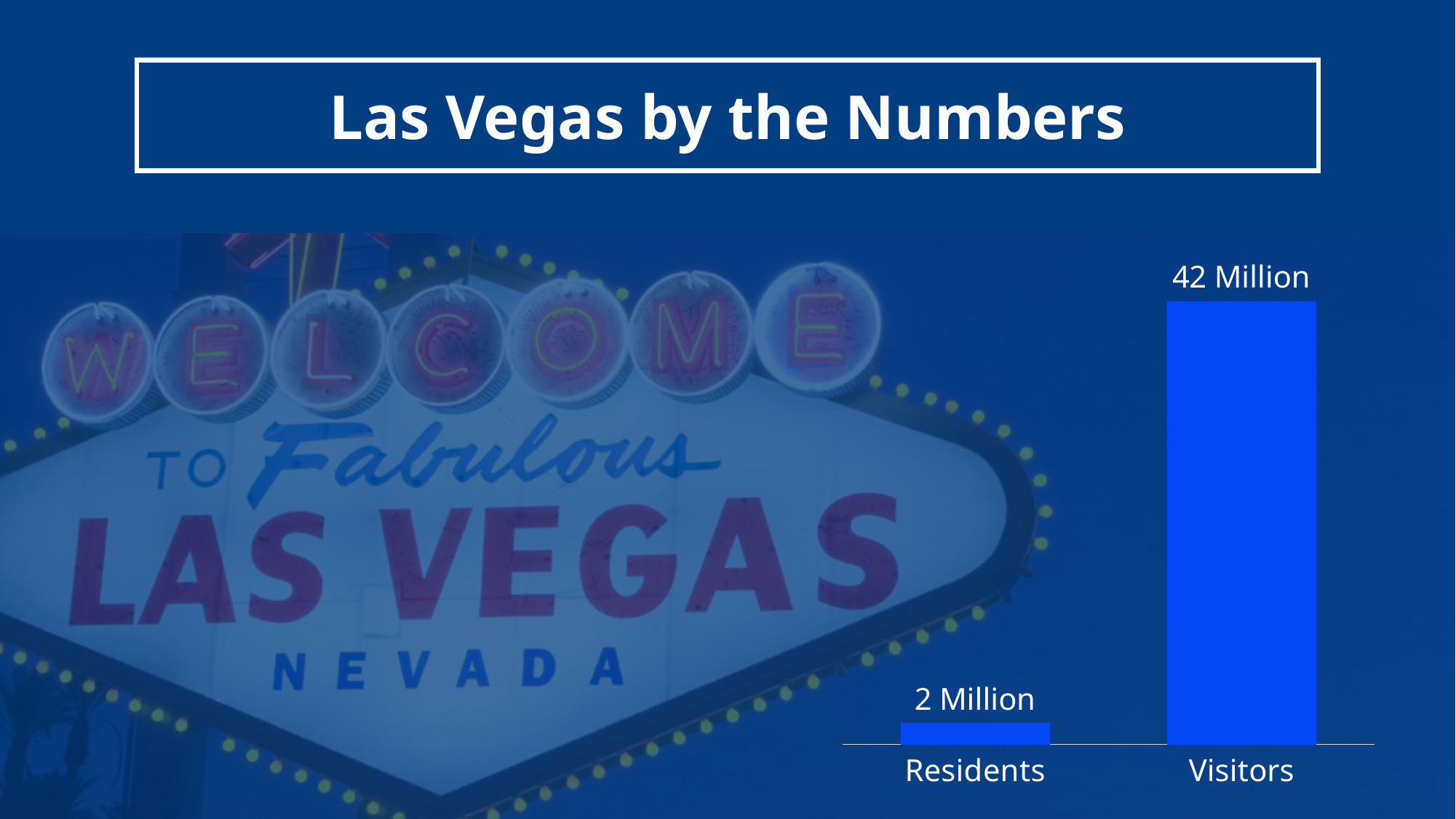
What is the total of the Residents and Visitors values combined? 44 Million How many categories are shown in the chart? 2 Which category has the highest value? Visitors What kind of chart is shown on the slide? Bar chart What is the value for Visitors? 42 Million Which is larger, the value for Residents or the value for Visitors? Visitors What is the difference between the values for Visitors and Residents? 40 Million What is the title of the slide containing the chart? Las Vegas by the Numbers Which category has the lowest value? Residents What is the value for Residents? 2 Million